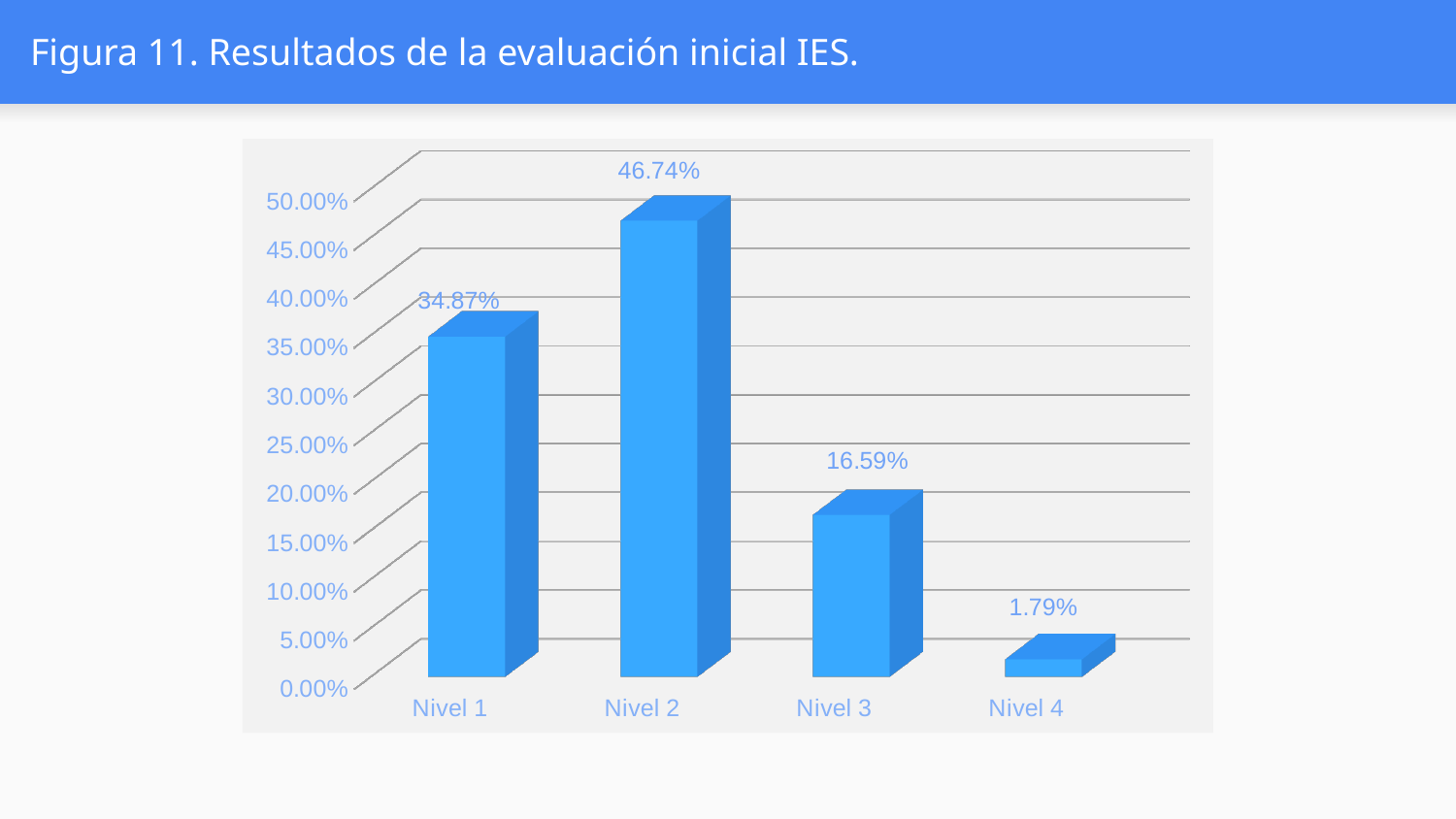
What kind of chart is shown on the slide? bar chart Which category has the lowest value? Nivel 4 Which category has the highest value? Nivel 2 Which is larger, the value for Nivel 1 or the value for Nivel 3? Nivel 1 What is the value for Nivel 3? 16.59% What is the value for Nivel 1? 34.87% What is the difference between the values for Nivel 2 and Nivel 1? 11.87% What is the value for Nivel 2? 46.74% What is the value for Nivel 4? 1.79% What is the title of the slide? Figura 11. Resultados de la evaluación inicial IES. How many categories are shown on the x axis? 4 Is the value for Nivel 3 greater or less than 20.00%? less